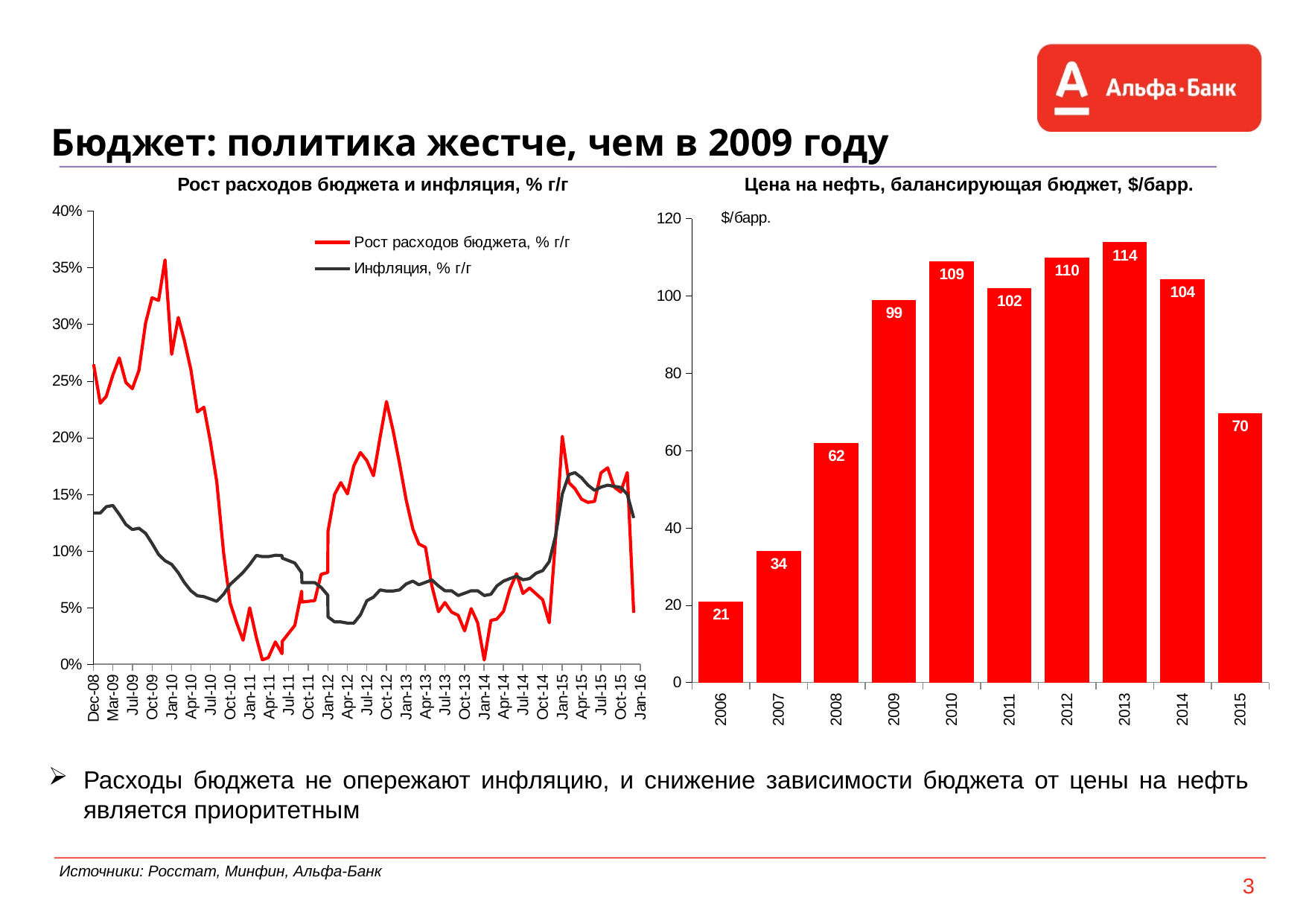
On the chart 'Цена на нефть, балансирующая бюджет, $/барр.', what is the difference between the values for 2008 and 2007? 28 On the chart 'Рост расходов бюджета и инфляция, % г/г', does the 'Инфляция, % г/г' line rise or fall between Jan-11 and Jan-12? fall On the chart 'Цена на нефть, балансирующая бюджет, $/барр.', what is the difference between the values for 2013 and 2015? 44 How many series does the legend of the chart 'Рост расходов бюджета и инфляция, % г/г' list? 2 On the chart 'Цена на нефть, балансирующая бюджет, $/барр.', which year has the highest value? 2013 On the chart 'Цена на нефть, балансирующая бюджет, $/барр.', what is the value for 2015? 70 On the chart 'Цена на нефть, балансирующая бюджет, $/барр.', which year has the larger value, 2010 or 2011? 2010 On the chart 'Цена на нефть, балансирующая бюджет, $/барр.', what is the value for 2013? 114 On the chart 'Цена на нефть, балансирующая бюджет, $/барр.', which year has the lowest value? 2006 What kind of chart is 'Цена на нефть, балансирующая бюджет, $/барр.'? bar chart How many years are shown on the chart 'Цена на нефть, балансирующая бюджет, $/барр.'? 10